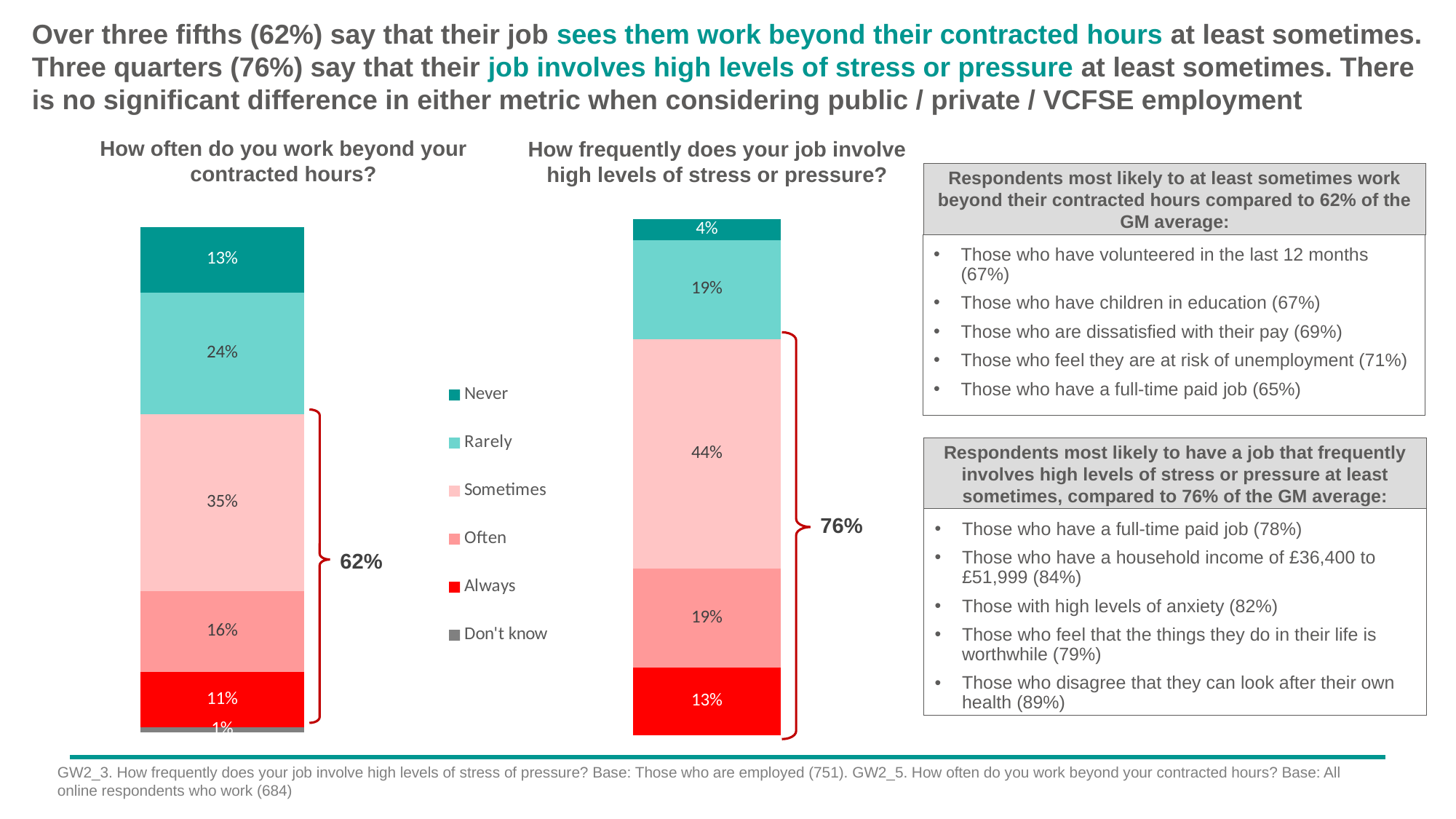
In the chart 'How often do you work beyond your contracted hours?', which response category has the smallest share? Don't know What type of chart is used for 'How often do you work beyond your contracted hours?'? Stacked bar chart In the chart 'How frequently does your job involve high levels of stress or pressure?', what percentage answered 'Always'? 13% How many entries does the legend shared by the two charts list? 6 Is the 'Sometimes' share larger in the chart 'How often do you work beyond your contracted hours?' or in the chart 'How frequently does your job involve high levels of stress or pressure?'? How frequently does your job involve high levels of stress or pressure? In the chart 'How frequently does your job involve high levels of stress or pressure?', what is the combined percentage of 'Sometimes', 'Often' and 'Always'? 76% In the chart 'How often do you work beyond your contracted hours?', what percentage answered 'Never'? 13% In the chart 'How often do you work beyond your contracted hours?', what percentage of respondents answered 'Sometimes'? 35% In the chart 'How often do you work beyond your contracted hours?', what is the difference between the 'Rarely' and 'Often' percentages? 8% In the chart 'How frequently does your job involve high levels of stress or pressure?', which response category has the largest share? Sometimes In the chart 'How often do you work beyond your contracted hours?', what percentage answered 'Always'? 11%